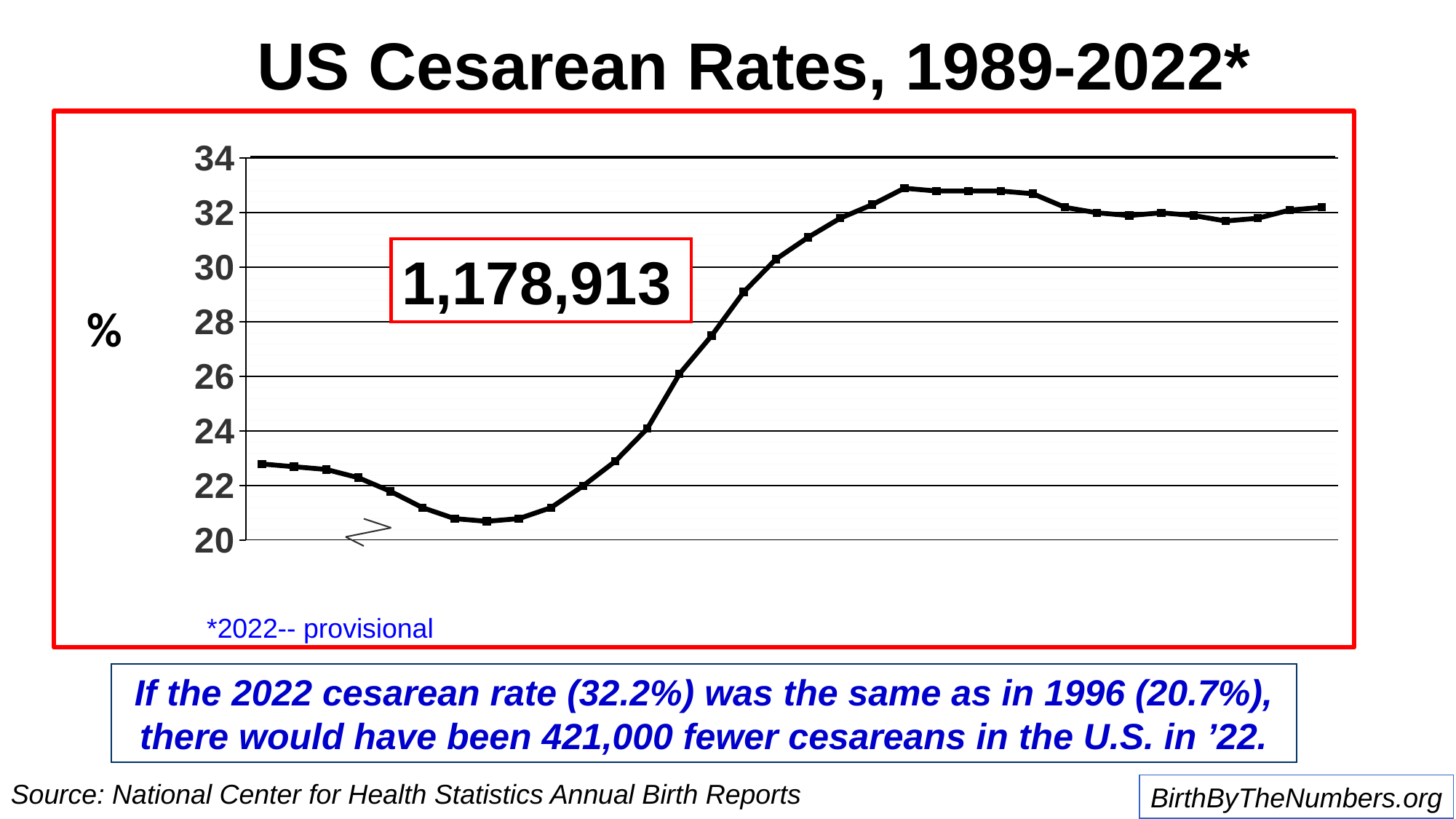
According to the slide, what was the US cesarean rate in 2022? 32.2% Is the leftmost point on the line greater or less than 22? greater What label is shown on the y axis of the chart? % What is the title of the chart? US Cesarean Rates, 1989-2022* Which is higher, the leftmost point on the line or the rightmost point? the rightmost point Overall, does the cesarean rate rise or fall from the left of the chart to the right? rise According to the slide, what was the US cesarean rate in 1996? 20.7% Is the rightmost point on the line greater or less than 30? greater What kind of chart is shown on the slide? line chart By how many percentage points does the 2022 cesarean rate (32.2%) exceed the 1996 rate (20.7%)? 11.5 Is the lowest point on the line greater or less than 22? less